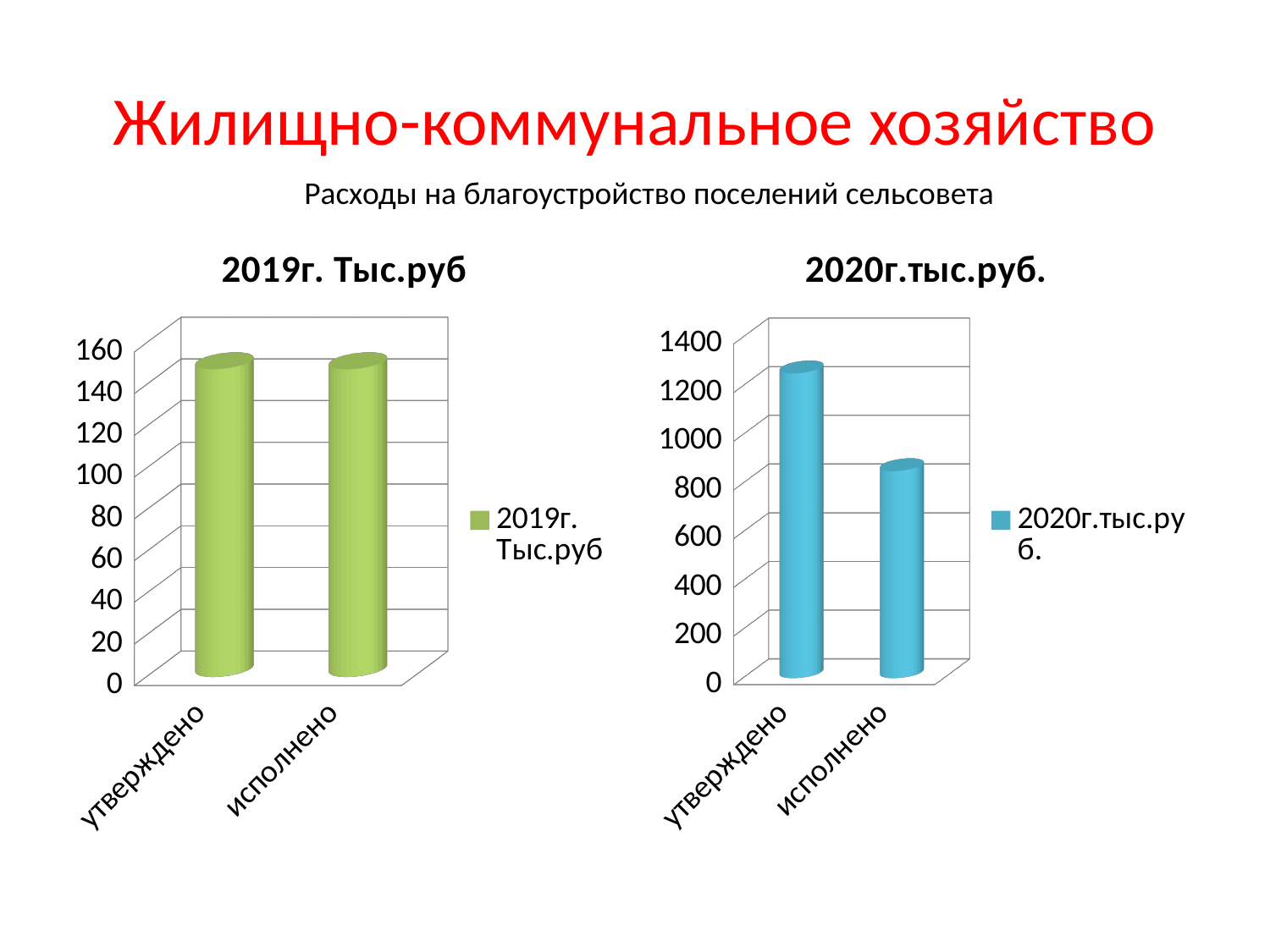
On the "2020г.тыс.руб." chart, which is larger: утверждено or исполнено? утверждено What kind of chart is the "2020г.тыс.руб." chart? bar chart How many categories are shown on the "2019г. Тыс.руб" chart? 2 On the "2019г. Тыс.руб" chart, is the value for утверждено greater or less than 100? greater On the "2020г.тыс.руб." chart, which category has the lowest value? исполнено How many categories are shown on the "2020г.тыс.руб." chart? 2 How many series does the legend of the "2020г.тыс.руб." chart list? 1 On the "2020г.тыс.руб." chart, is the value for утверждено greater or less than 1000? greater On the "2020г.тыс.руб." chart, which category has the highest value? утверждено On the "2020г.тыс.руб." chart, is the value for исполнено greater or less than 1000? less What is the legend entry on the "2019г. Тыс.руб" chart? 2019г. Тыс.руб What kind of chart is the "2019г. Тыс.руб" chart? bar chart